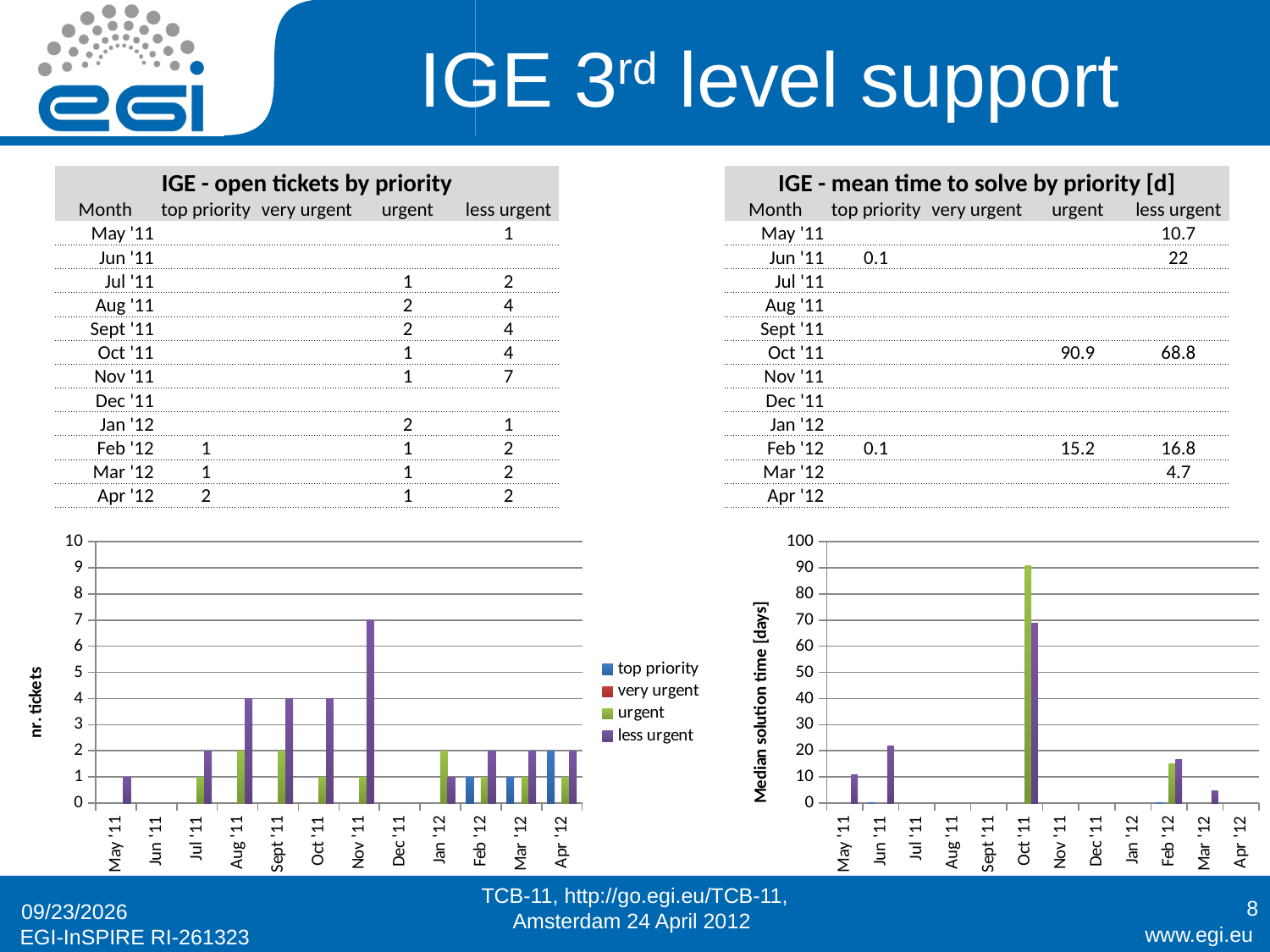
In the right chart (mean time to solve by priority), what is the difference between the urgent and less urgent values for Oct '11? 22.1 In the right chart (mean time to solve by priority), is the less urgent value for Oct '11 greater or less than 60? greater In the right chart (mean time to solve by priority), which is larger for Oct '11, urgent or less urgent? urgent In the left chart (open tickets by priority), which month has the highest less urgent bar? Nov '11 In the right chart (mean time to solve by priority), what is the less urgent value for Jun '11? 22 In the left chart (open tickets by priority), what is the number of less urgent tickets in Nov '11? 7 In the left chart (open tickets by priority), what is the difference between the less urgent values for Nov '11 and Aug '11? 3 In the left chart (open tickets by priority), what is the top priority value for Apr '12? 2 How many months are shown on the x axis of the right chart (mean time to solve by priority)? 12 In the right chart (mean time to solve by priority), what is the urgent value for Oct '11? 90.9 What kind of chart is the left chart (open tickets by priority)? bar chart How many series does the legend of the left chart list? 4